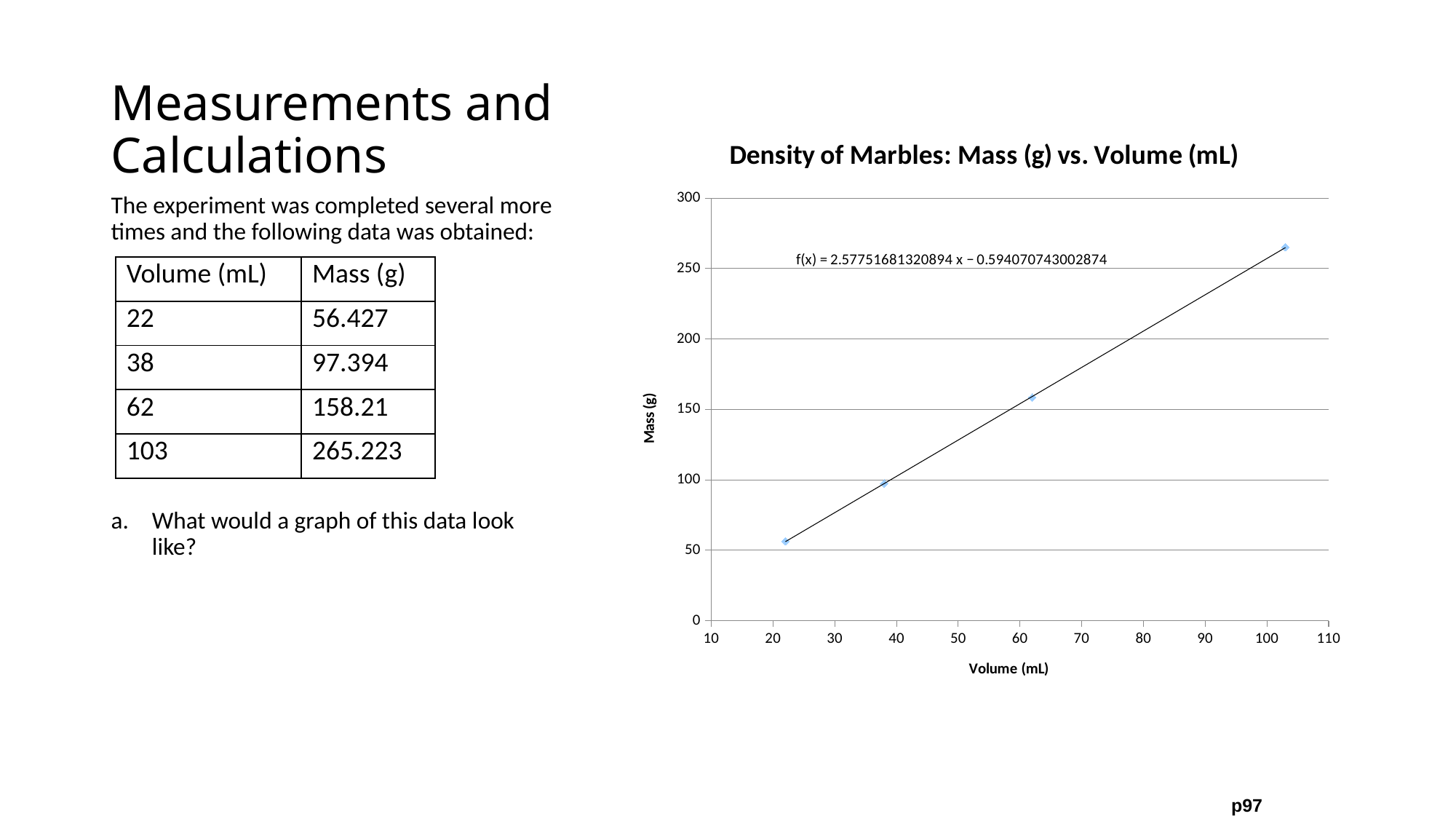
What is the difference in mass (g) between the points at 103 mL and 22 mL? 208.796 What kind of chart is shown on the slide? scatter chart Does the mass rise or fall as volume increases along the x axis? rise What is the mass (g) plotted for a volume of 103 mL? 265.223 At which volume (mL) is the plotted mass lowest? 22 What is the label on the x axis of the chart? Volume (mL) Is the mass plotted at a volume of 38 mL greater or less than 100? less Is the mass plotted at a volume of 62 mL greater or less than 150? greater What is the title of the chart? Density of Marbles: Mass (g) vs. Volume (mL) How many data points are plotted on the chart? 4 At which volume (mL) is the plotted mass highest? 103